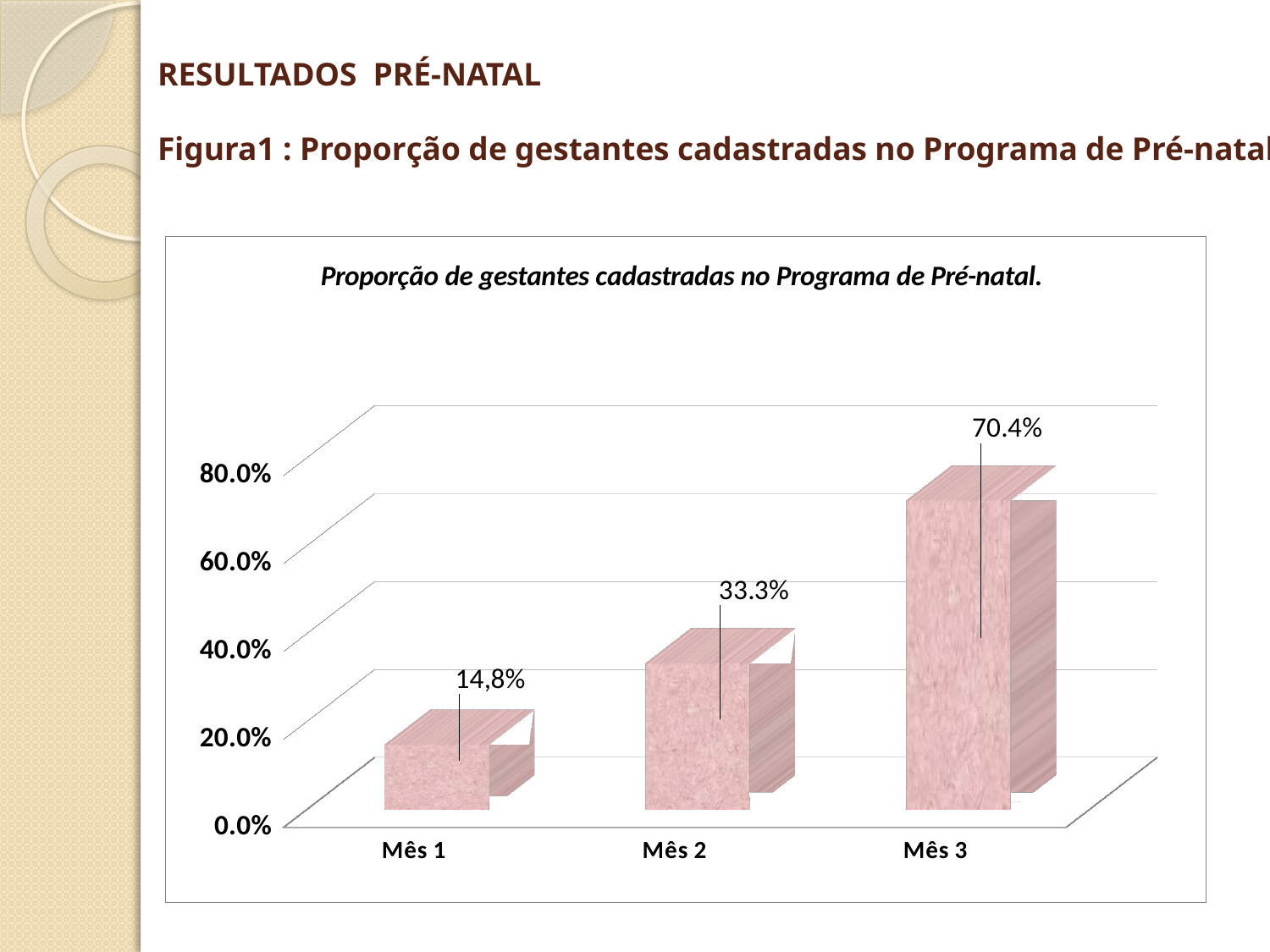
What kind of chart is shown? bar chart Is the value for Mês 1 greater or less than 20.0%? less Do the values rise or fall from Mês 1 to Mês 3? rise Which is larger, the value for Mês 2 or the value for Mês 1? Mês 2 Which month has the lowest proportion? Mês 1 What is the value for Mês 3? 70.4% What is the value for Mês 2? 33.3% How many months are shown on the x axis? 3 What is the difference between the values for Mês 3 and Mês 2? 37.1% Which month has the highest proportion? Mês 3 Is the value for Mês 3 greater or less than 60.0%? greater What is the value for Mês 1? 14,8%